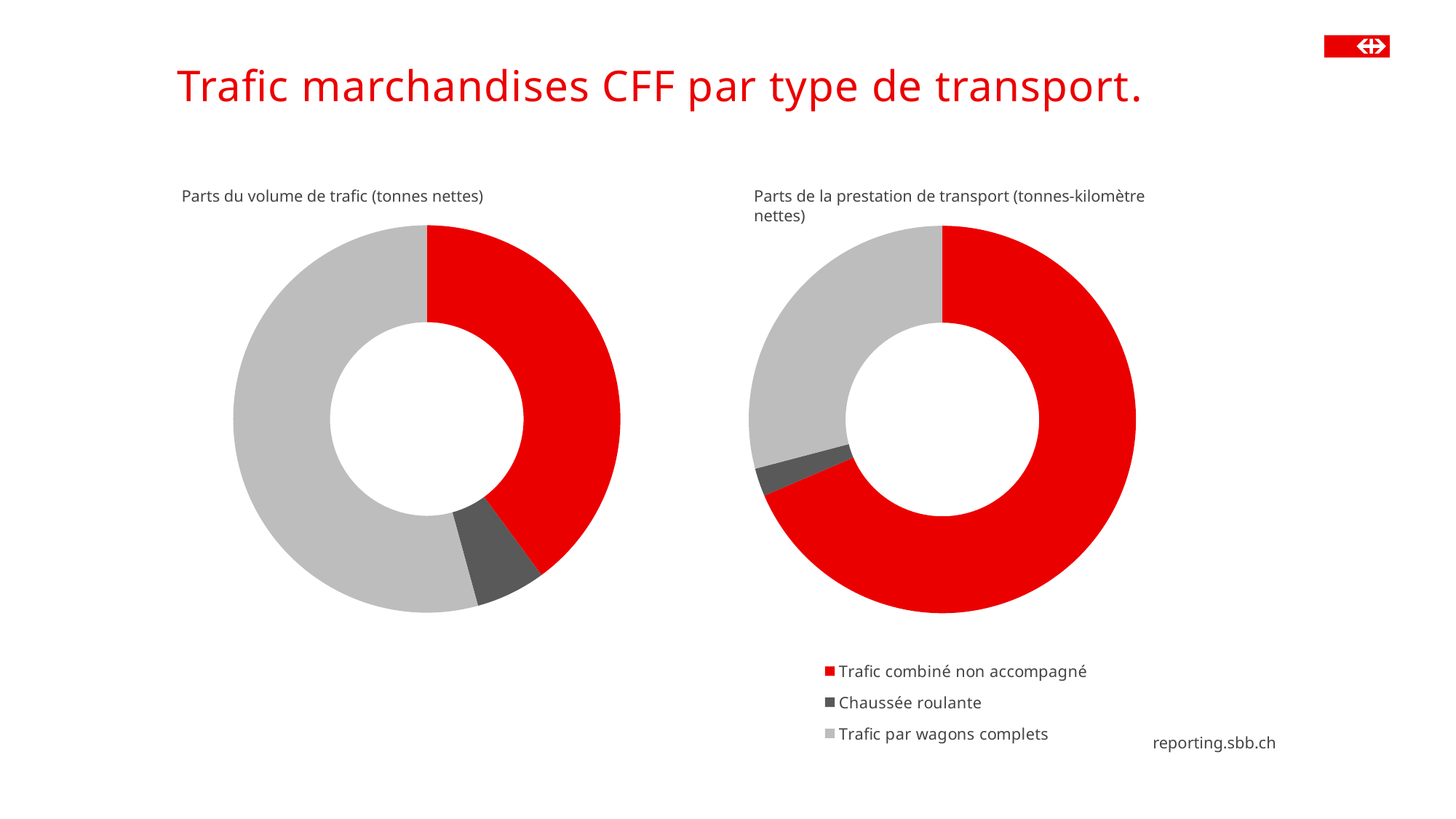
Which colour represents 'Chaussée roulante' in the charts? Dark grey How many categories does the legend list for the charts? 3 In the left chart, 'Parts du volume de trafic (tonnes nettes)', which is larger: the share of Trafic par wagons complets or the share of Trafic combiné non accompagné? Trafic par wagons complets What kind of chart is the left chart, 'Parts du volume de trafic (tonnes nettes)'? Doughnut (pie) chart In the left chart, 'Parts du volume de trafic (tonnes nettes)', which category has the smallest share? Chaussée roulante In the right chart, 'Parts de la prestation de transport (tonnes-kilomètre nettes)', which category has the largest share? Trafic combiné non accompagné In the right chart, 'Parts de la prestation de transport (tonnes-kilomètre nettes)', which category has the smallest share? Chaussée roulante What kind of chart is the right chart, 'Parts de la prestation de transport (tonnes-kilomètre nettes)'? Doughnut (pie) chart What is the title of the slide? Trafic marchandises CFF par type de transport. In the right chart, 'Parts de la prestation de transport (tonnes-kilomètre nettes)', which is larger: the share of Trafic combiné non accompagné or the share of Trafic par wagons complets? Trafic combiné non accompagné In the left chart, 'Parts du volume de trafic (tonnes nettes)', which category has the largest share? Trafic par wagons complets How many slices does the left chart, 'Parts du volume de trafic (tonnes nettes)', have? 3